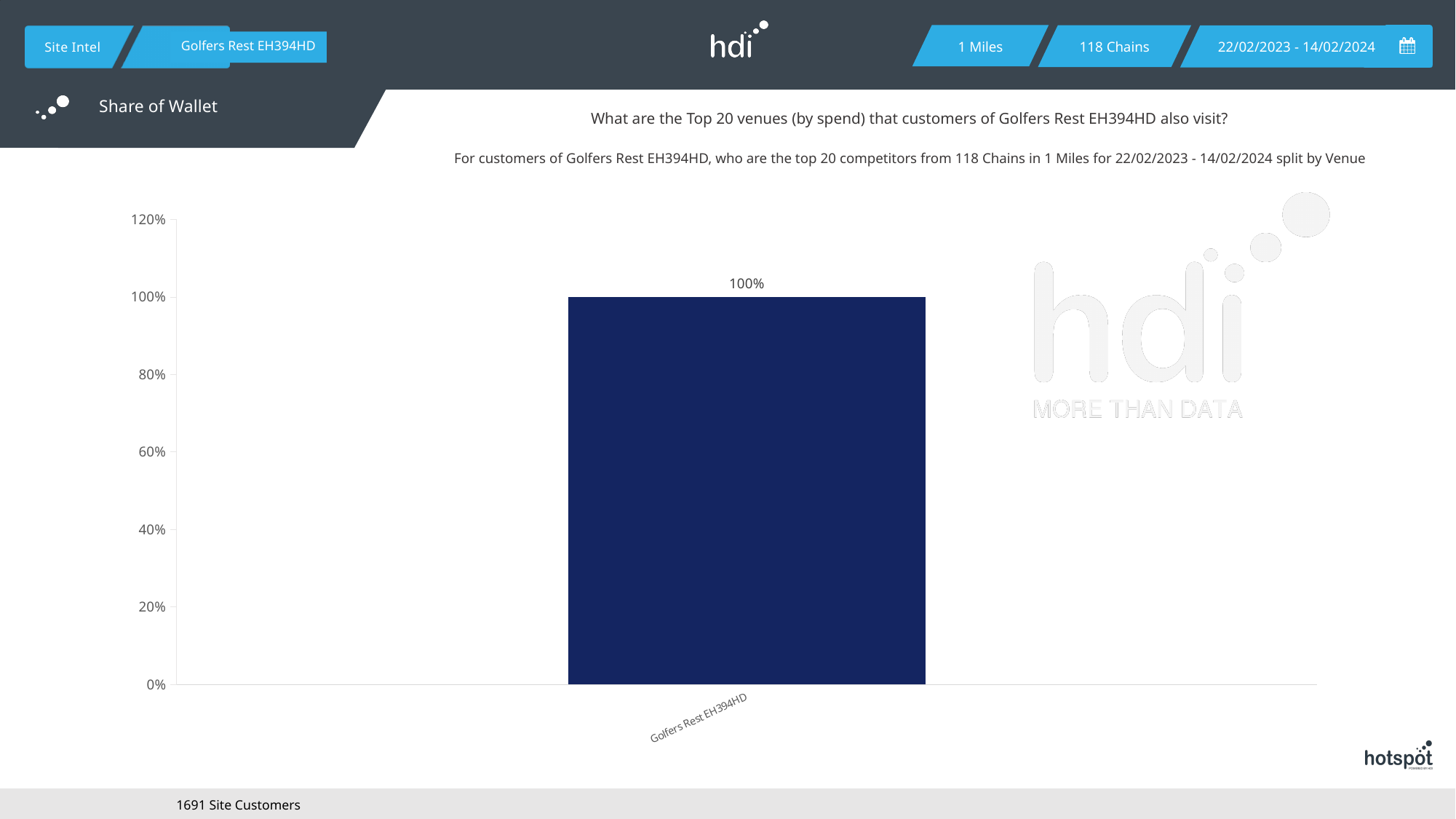
What is the highest value shown on the vertical axis? 120% What is the value shown for Golfers Rest EH394HD? 100% Is the value for Golfers Rest EH394HD greater or less than 120%? less How many bars are plotted on the chart? 1 Which category has the highest value on the chart? Golfers Rest EH394HD What is the label of the only category on the x axis? Golfers Rest EH394HD What kind of chart is shown on the slide? bar chart Is the value for Golfers Rest EH394HD greater or less than 80%? greater